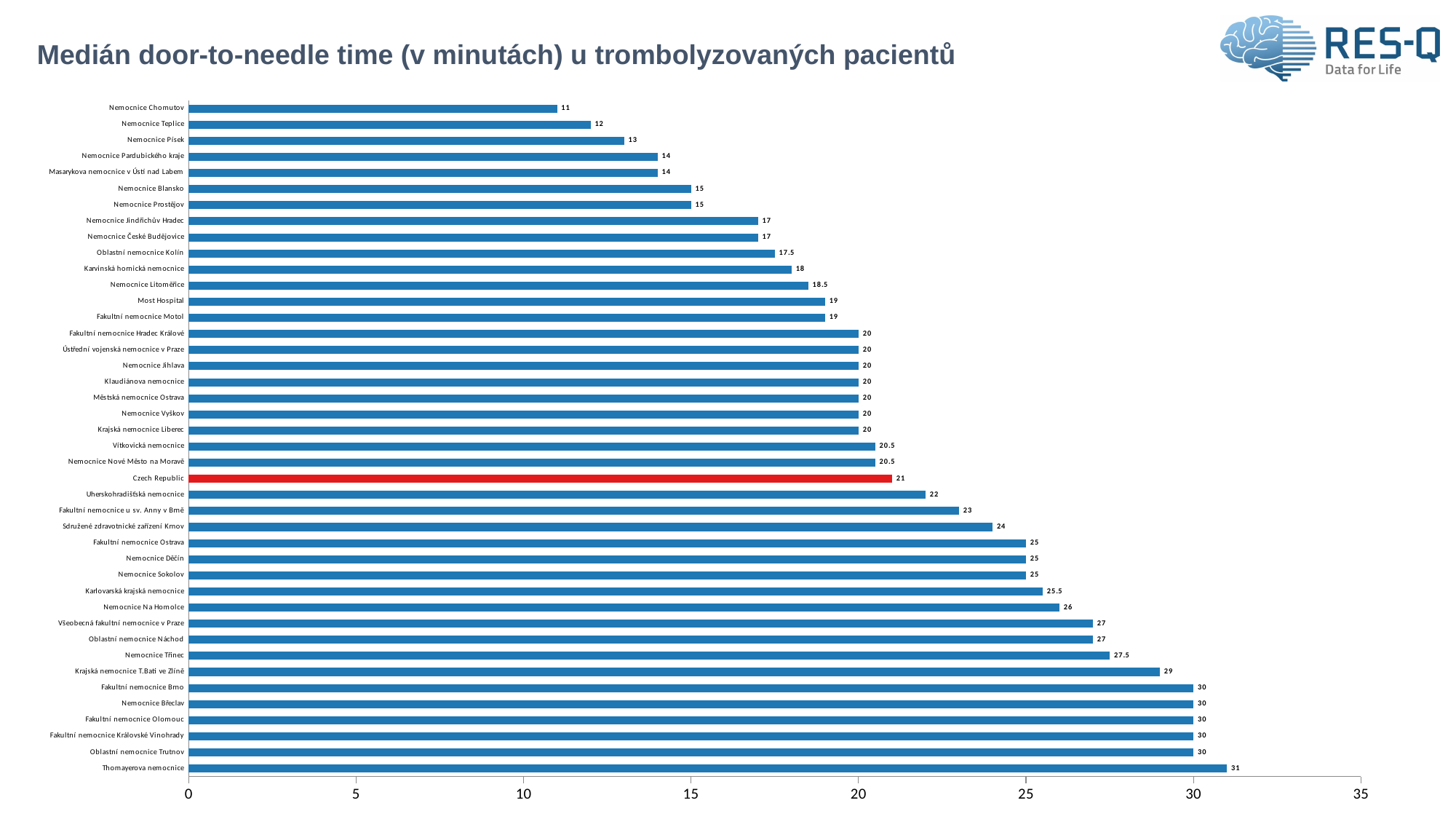
What is the value for Nemocnice Litoměřice? 18.5 Which hospital has the highest median door-to-needle time? Thomayerova nemocnice What kind of chart is shown on the slide? Bar chart Which hospital has the lowest median door-to-needle time? Nemocnice Chomutov What is the value for Krajská nemocnice T.Bati ve Zlíně? 29 What is the median door-to-needle time for Czech Republic? 21 What is the difference between the values for Thomayerova nemocnice and Nemocnice Chomutov? 20 Which has a larger value, Nemocnice Sokolov or Nemocnice Teplice? Nemocnice Sokolov Which bar is highlighted in red? Czech Republic What is the difference between the values for Nemocnice Na Homolce and Czech Republic? 5 Is the value for Fakultní nemocnice Brno greater or less than 25? greater How many categories (bars) are shown in the chart? 42